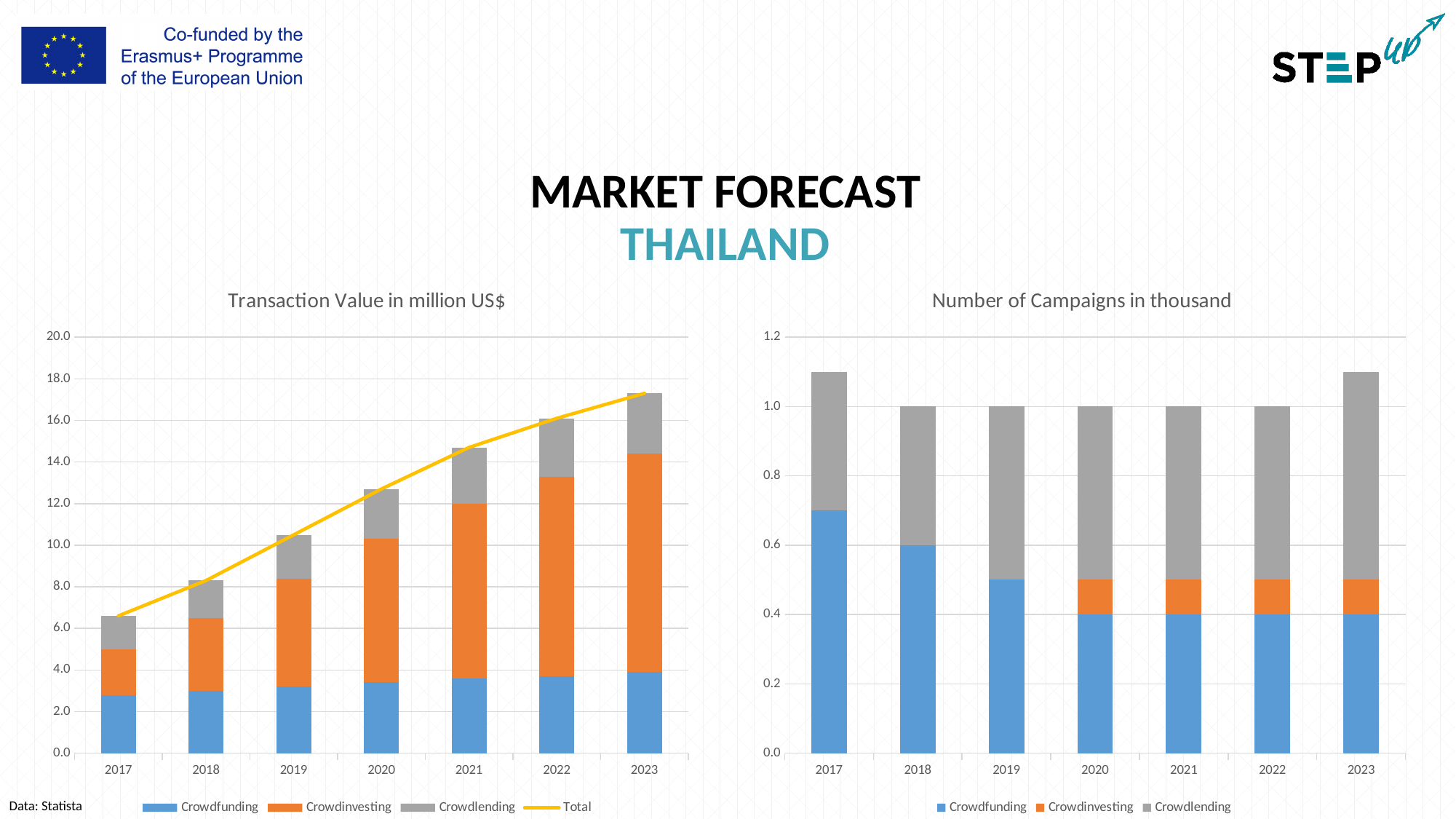
In the 'Transaction Value in million US$' chart, is the total for 2017 greater or less than 8.0? less In the 'Number of Campaigns in thousand' chart, is the Crowdfunding value for 2017 greater or less than 0.6? greater How many series does the legend of the 'Transaction Value in million US$' chart list? 4 How many years are shown on the x axis of the 'Transaction Value in million US$' chart? 7 In the 'Number of Campaigns in thousand' chart, which year has the highest Crowdfunding value? 2017 In the 'Transaction Value in million US$' chart, which series is shown in orange? Crowdinvesting In the 'Transaction Value in million US$' chart, which year has the highest total transaction value? 2023 In the 'Transaction Value in million US$' chart, does the Total line rise or fall from 2017 to 2023? rise In the 'Transaction Value in million US$' chart, which year has the lowest total transaction value? 2017 How many series does the legend of the 'Number of Campaigns in thousand' chart list? 3 What kind of chart is the 'Number of Campaigns in thousand' chart? stacked bar chart In the 'Transaction Value in million US$' chart, is the total for 2023 greater or less than 16.0? greater